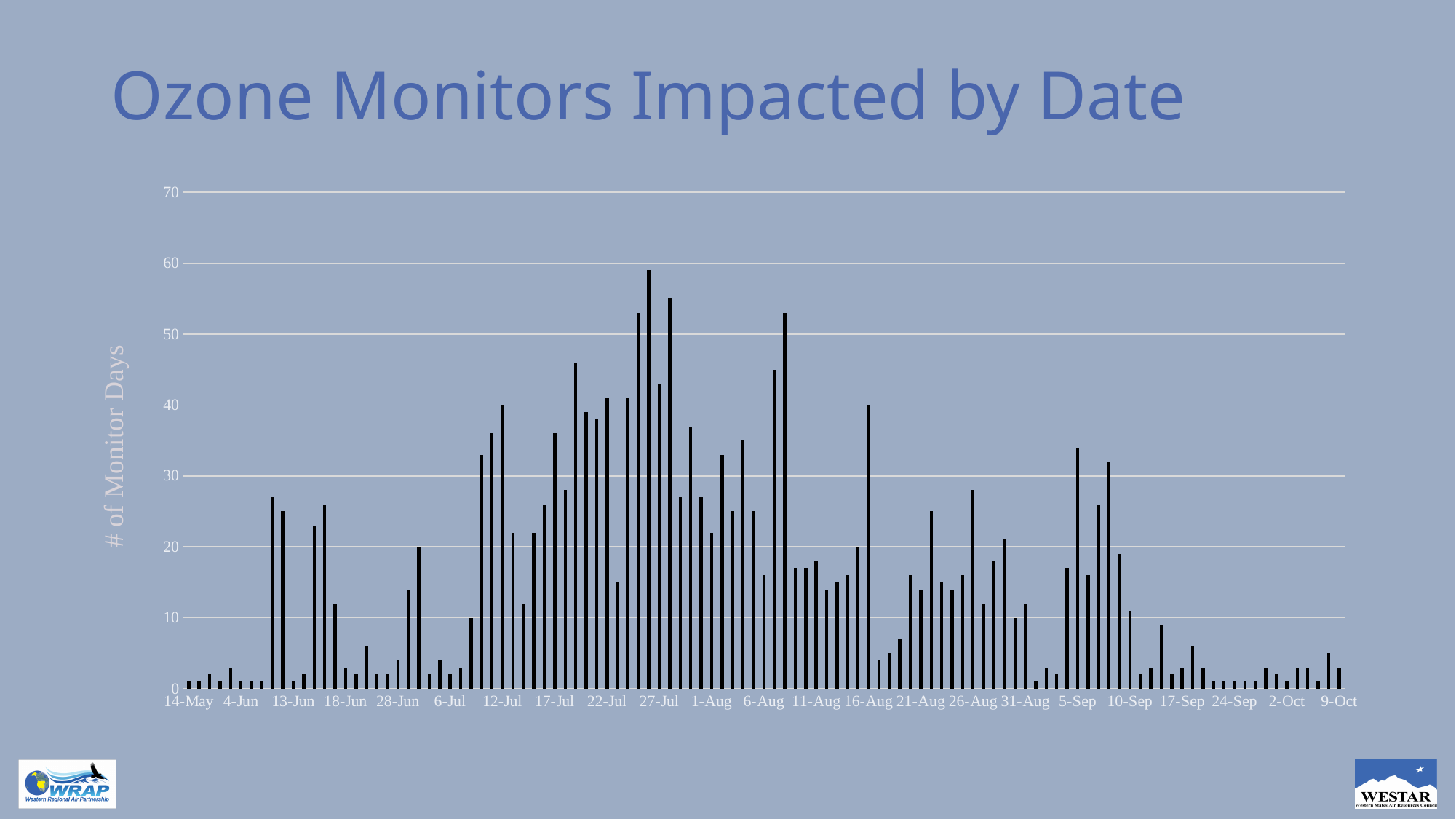
Is the value for 27-Jul greater or less than 30? greater Is the value for 12-Jul greater or less than 30? greater Is the value for 24-Sep greater or less than 10? less Which has the larger value, 22-Jul or 9-Oct? 22-Jul Which has the larger value, 17-Jul or 4-Jun? 17-Jul What kind of chart is shown on the slide? bar chart What is the label on the vertical axis? # of Monitor Days What is the title of the chart? Ozone Monitors Impacted by Date